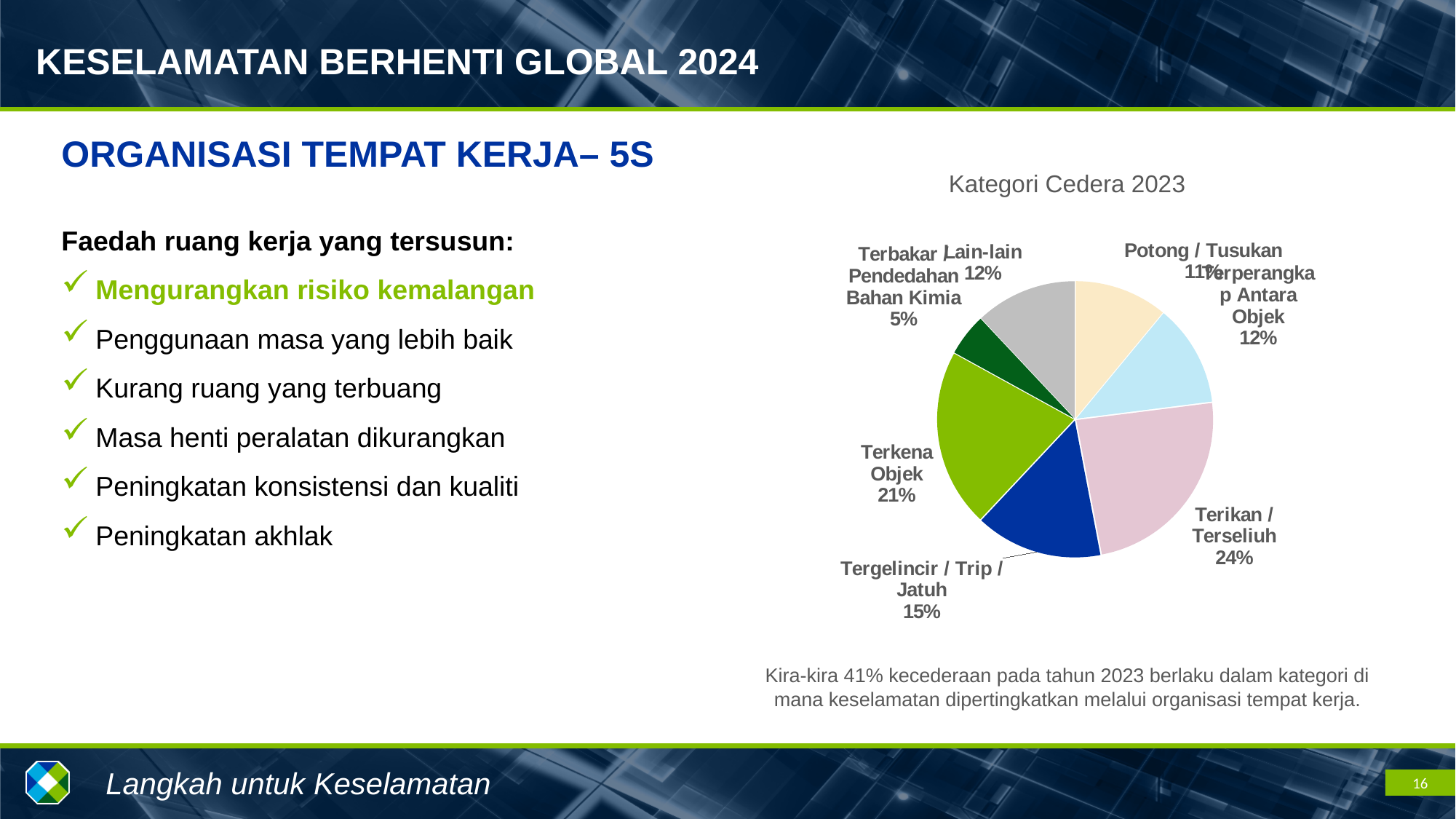
What share of the pie is Tergelincir / Trip / Jatuh? 15% What share of the pie is Terikan / Terseliuh? 24% What is the title of the chart? Kategori Cedera 2023 Which category has the smallest share of the pie? Terbakar / Pendedahan Bahan Kimia What share of the pie is Lain-lain? 12% Which category has the largest share of the pie? Terikan / Terseliuh Which is larger, Tergelincir / Trip / Jatuh or Potong / Tusukan? Tergelincir / Trip / Jatuh What type of chart is shown on the slide? pie chart How many categories are shown in the pie chart? 7 What share of the pie is Terbakar / Pendedahan Bahan Kimia? 5% What is the difference in percentage points between Terikan / Terseliuh and Terkena Objek? 3 What share of the pie is Terkena Objek? 21%